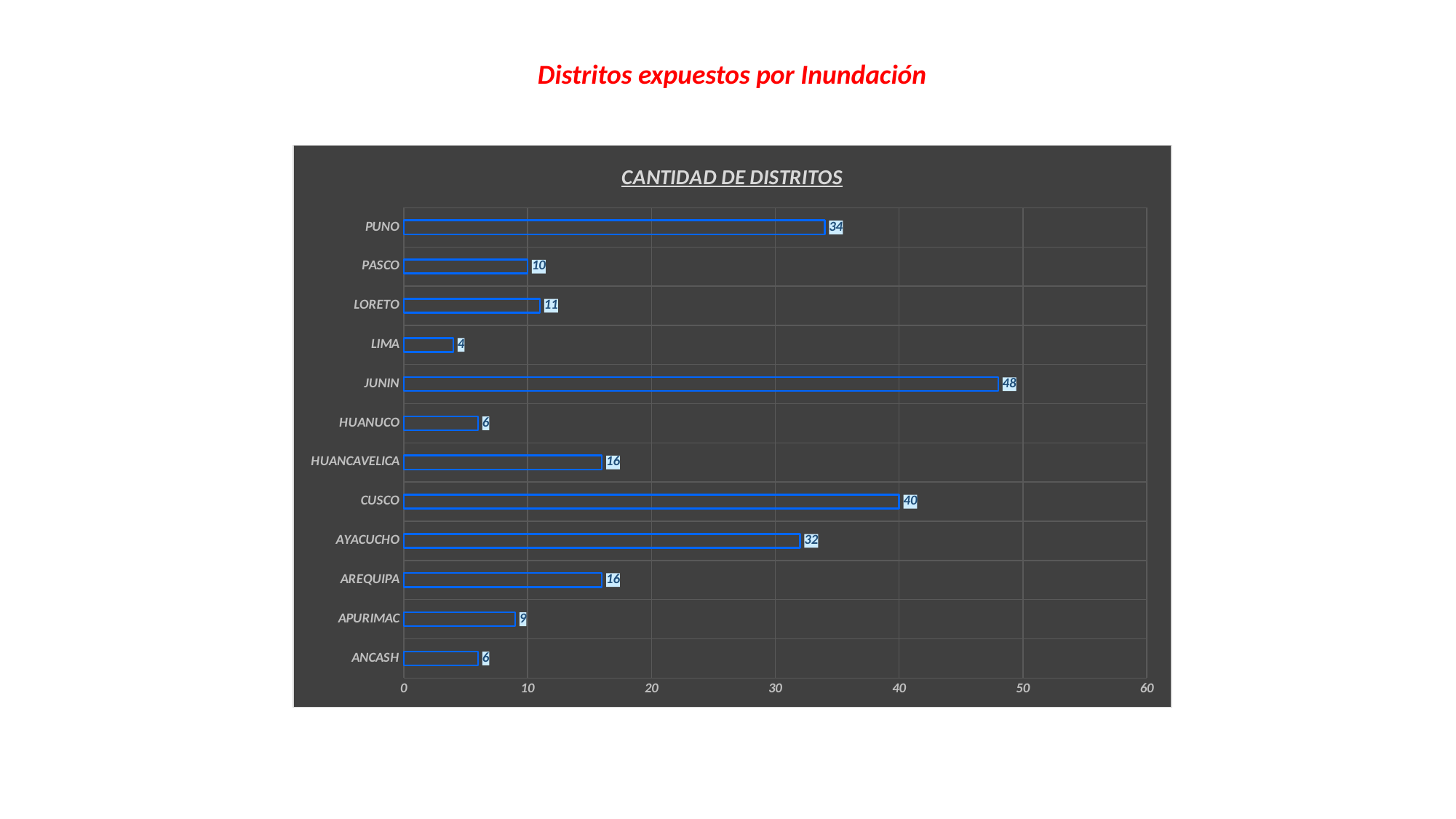
What is the value for CUSCO? 40 Which category has the lowest value? LIMA What kind of chart is shown? bar chart What is the title of the chart? CANTIDAD DE DISTRITOS How many categories are shown in the chart? 12 What is the difference between the values for HUANCAVELICA and HUANUCO? 10 What is the value for LIMA? 4 What is the difference between the values for JUNIN and PUNO? 14 What is the value for JUNIN? 48 Is the value for PUNO greater or less than 30? greater Which category has the highest value? JUNIN Which is larger, the value for AYACUCHO or the value for CUSCO? CUSCO